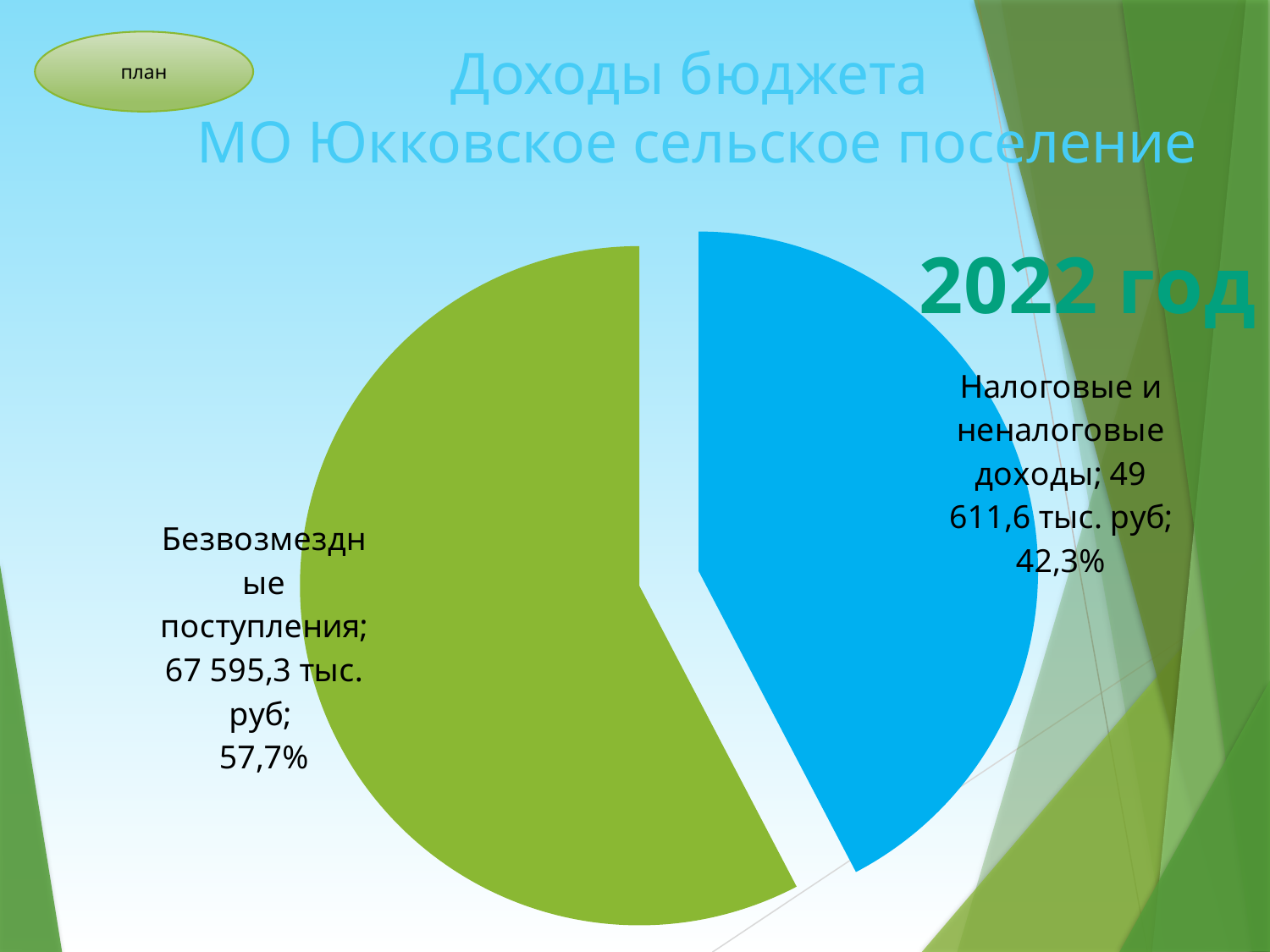
Which is larger, Безвозмездные поступления or Налоговые и неналоговые доходы? Безвозмездные поступления Which year does the chart refer to? 2022 год Which slice is the largest? Безвозмездные поступления What colour is the slice for Налоговые и неналоговые доходы? Blue What share of the pie does Безвозмездные поступления represent? 57,7% How many slices does the pie chart have? 2 What is the value for Безвозмездные поступления? 67 595,3 тыс. руб What share of the pie does Налоговые и неналоговые доходы represent? 42,3% What kind of chart is shown on the slide? Pie chart What is the difference in тыс. руб between Безвозмездные поступления and Налоговые и неналоговые доходы? 17 983,7 тыс. руб Which slice is the smallest? Налоговые и неналоговые доходы What is the value for Налоговые и неналоговые доходы? 49 611,6 тыс. руб